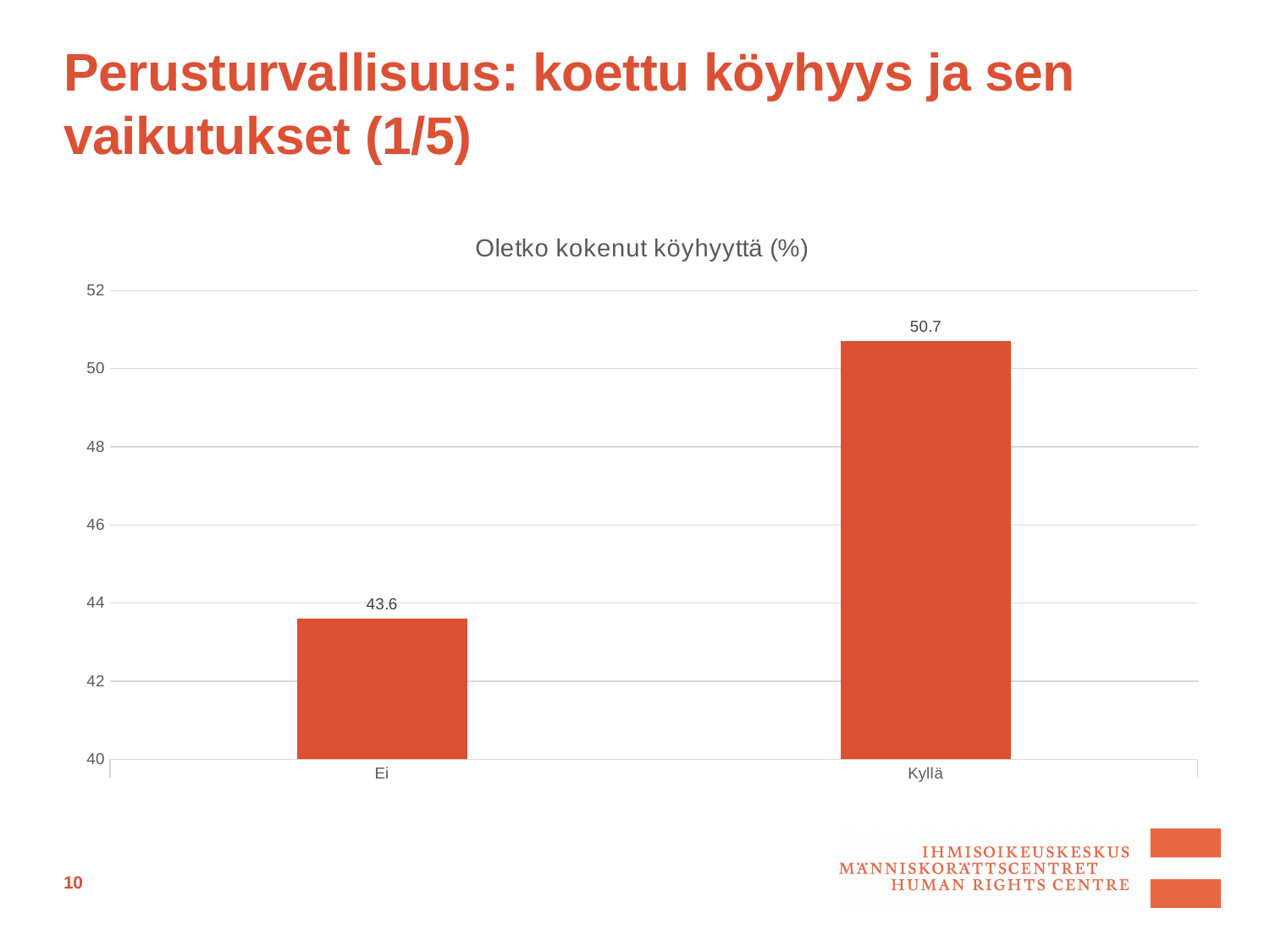
What colour are the bars in the chart? orange-red Which is larger, the value for Ei or the value for Kyllä? Kyllä Is the value for Kyllä greater or less than 50? greater Is the value for Ei greater or less than 44? less What is the value for Ei? 43.6 Which category has the highest value? Kyllä What is the value for Kyllä? 50.7 What is the difference between the values for Kyllä and Ei? 7.1 How many categories are shown on the x axis? 2 What is the title of the chart? Oletko kokenut köyhyyttä (%) What kind of chart is shown on the slide? bar chart Which category has the lowest value? Ei